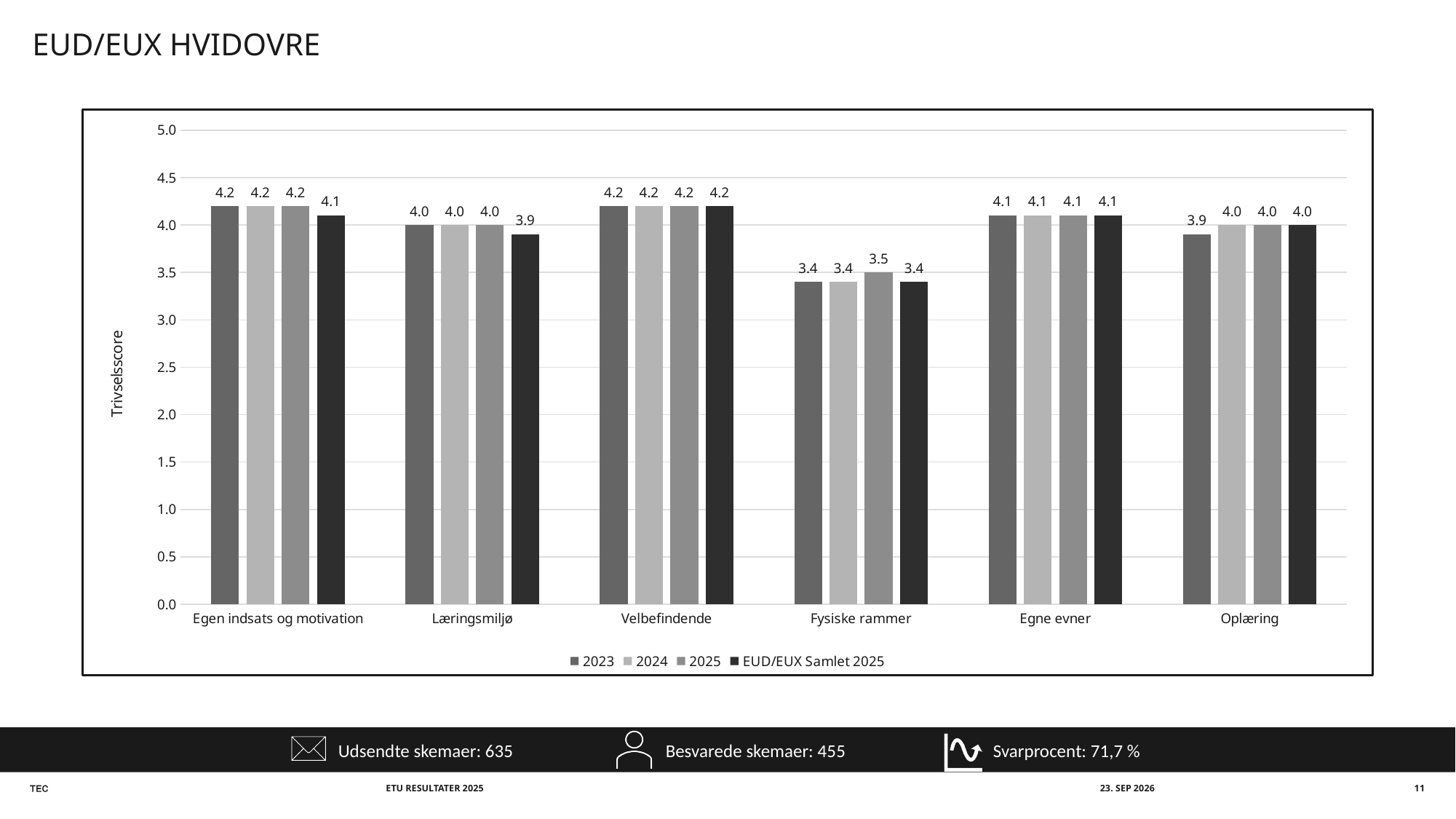
What is the 2025 value for Fysiske rammer? 3.5 What is the EUD/EUX Samlet 2025 value for Læringsmiljø? 3.9 What kind of chart is shown on the slide? bar chart What is the 2023 value for Oplæring? 3.9 How many series does the legend list? 4 Which category has the lowest 2023 value? Fysiske rammer What is the label of the y axis? Trivselsscore Which is larger: the 2023 value for Egen indsats og motivation or the 2023 value for Fysiske rammer? Egen indsats og motivation Is the 2024 value for Fysiske rammer greater or less than 4.0? less How many categories are shown on the x axis? 6 What is the difference between the 2025 value for Velbefindende and the 2025 value for Fysiske rammer? 0.7 What is the 2024 value for Egne evner? 4.1